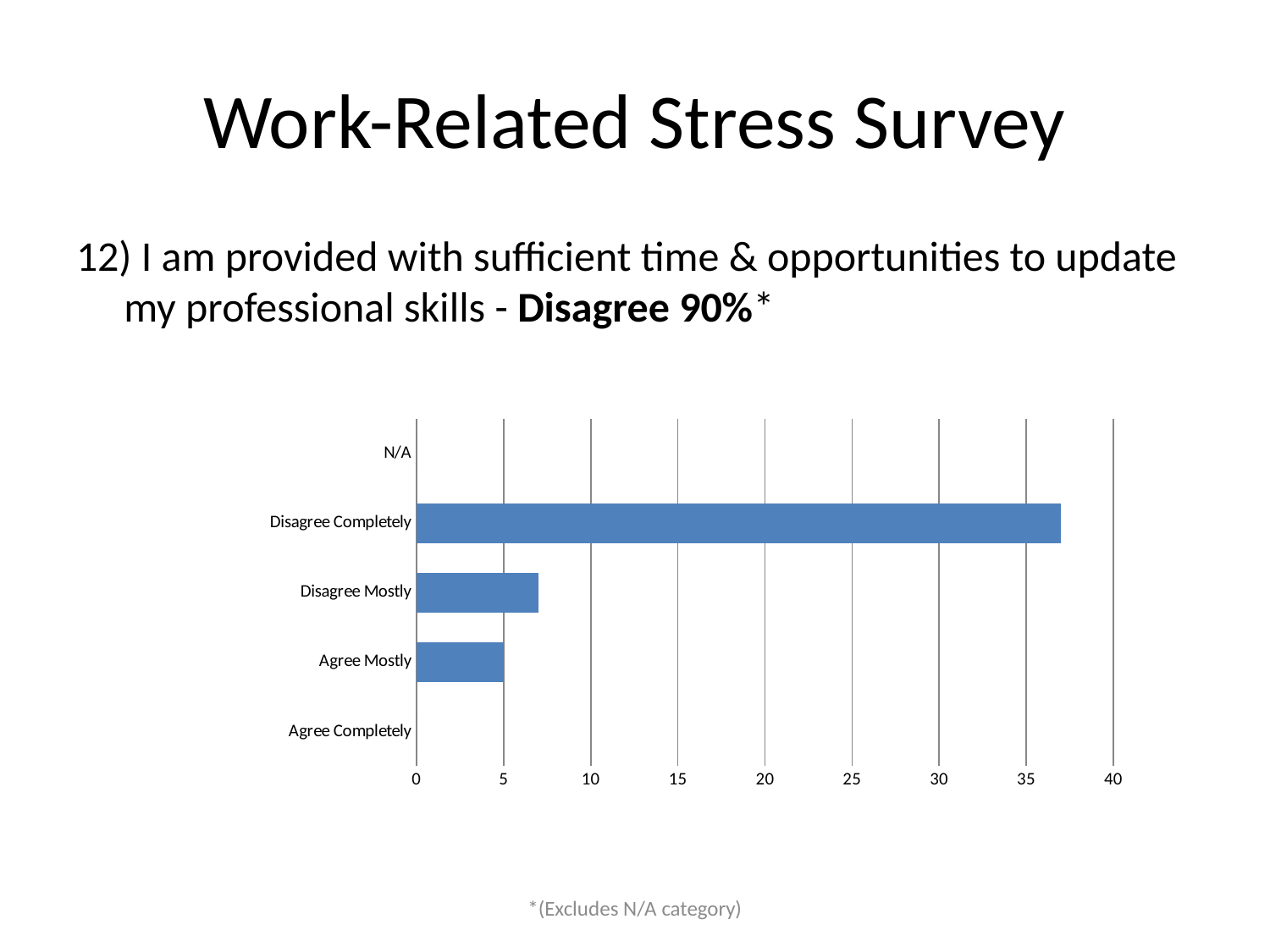
Which is larger, the value for Disagree Mostly or the value for Agree Mostly? Disagree Mostly Is the value for Disagree Mostly greater or less than 10? less Is the value for Disagree Mostly greater or less than 5? greater What kind of chart is shown on the slide? bar chart What is the value for Agree Mostly? 5 Which is larger, the value for Disagree Completely or the value for Disagree Mostly? Disagree Completely How many categories are shown on the chart's vertical axis? 5 According to the slide text, what percentage of respondents disagreed with statement 12? 90% Is the value for Disagree Completely greater or less than 35? greater What is the highest value shown on the horizontal axis? 40 Which category has the longest bar? Disagree Completely